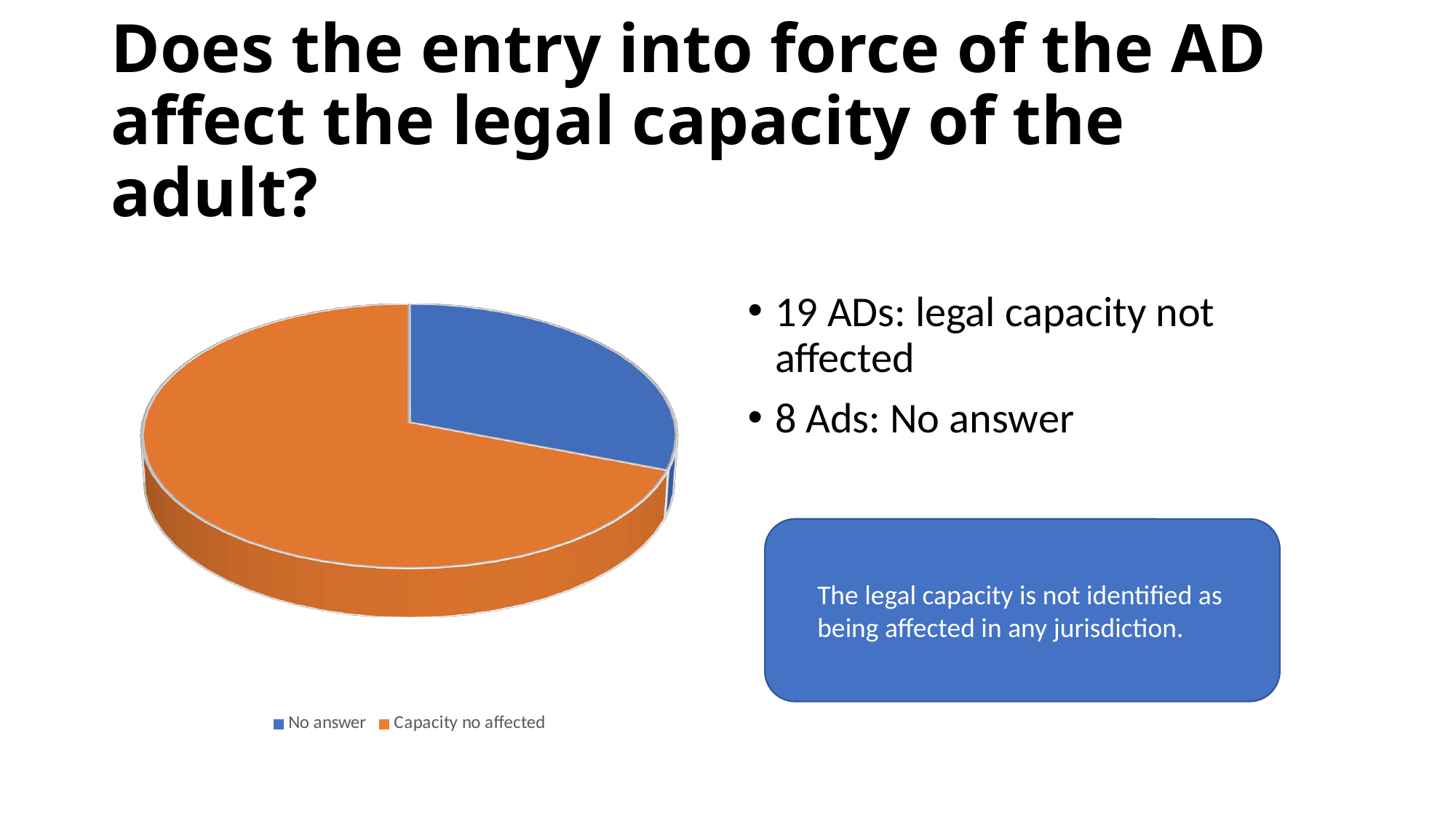
How many slices does the pie chart have? 2 How many entries does the legend of the pie chart list? 2 Which slice of the pie chart is the largest? Capacity no affected What is the difference between the number of ADs with legal capacity not affected and the number with no answer, as stated on the slide? 11 What colour is the "No answer" slice in the pie chart? blue What colour is the "Capacity no affected" slice in the pie chart? orange According to the slide, how many ADs reported that legal capacity is not affected? 19 What kind of chart is shown on the slide? pie chart Which slice is larger in the pie chart, "No answer" or "Capacity no affected"? Capacity no affected Which slice of the pie chart is the smallest? No answer According to the slide, how many ADs gave no answer? 8